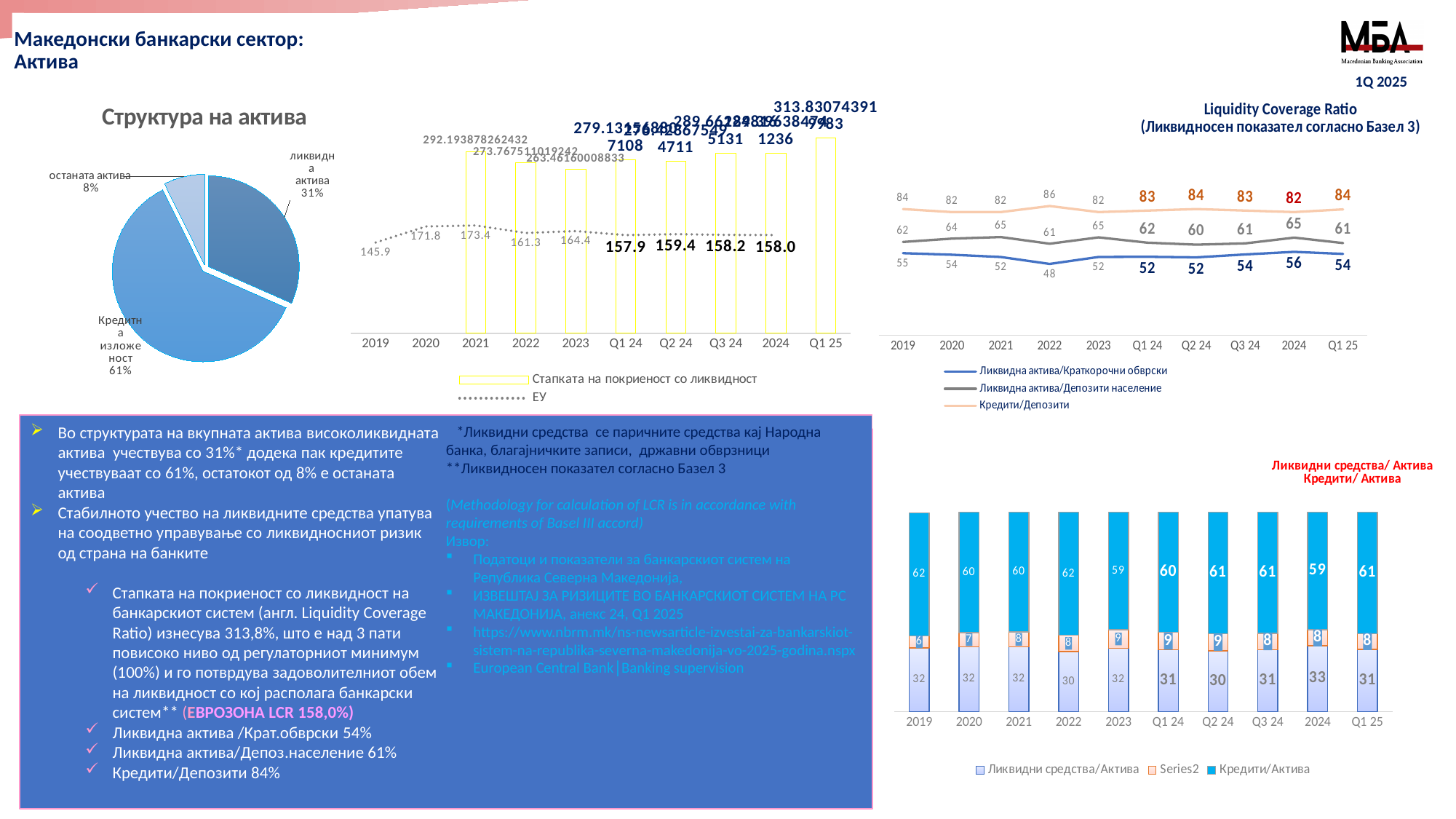
In the 'Liquidity Coverage Ratio' line chart, what is the value of 'Ликвидна актива/Краткорочни обврски' for 2022? 48 In the middle top chart with the yellow bars, what is the value of the 'ЕУ' line for 2019? 145.9 In the stacked bar chart at the bottom right, what is the total of the 2024 bar? 100 In the middle top chart with the yellow bars, how many series does the legend list? 2 In the pie chart 'Структура на актива', what is the share of 'останата актива'? 8% In the stacked bar chart at the bottom right, what is the value of 'Кредити/Актива' for 2023? 59 In the pie chart 'Структура на актива', what share does 'ликвидна актива' have? 31% In the 'Liquidity Coverage Ratio' line chart, what is the value of 'Кредити/Депозити' for Q1 25? 84 In the 'Liquidity Coverage Ratio' line chart, what is the difference between 'Кредити/Депозити' and 'Ликвидна актива/Депозити население' in 2024? 17 In the middle top chart with the yellow bars, what is the value of the 'ЕУ' line for Q2 24? 159.4 In the pie chart 'Структура на актива', which category has the largest share? Кредитна изложеност In the middle top chart with the yellow bars, what is the value of 'Стапката на покриеност со ликвидност' for Q1 25? 313.83074391